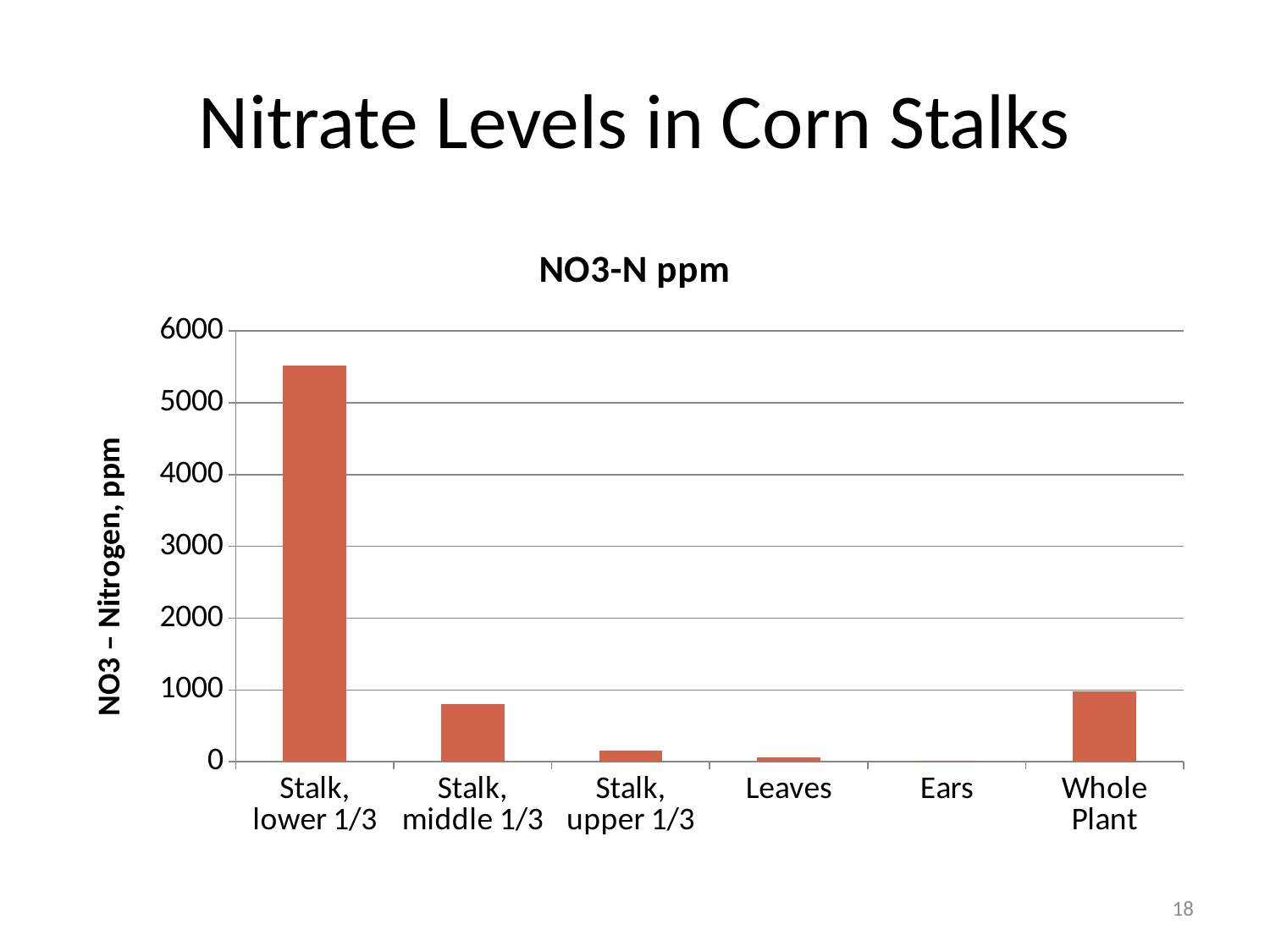
Is the value for Stalk, middle 1/3 greater or less than 1000? less Is the value for Stalk, upper 1/3 greater or less than 1000? less Is the value for Stalk, lower 1/3 greater or less than 5000? greater How many categories are shown on the x axis of the chart? 6 What kind of chart is shown on the slide? bar chart Which category has the highest NO3-N value? Stalk, lower 1/3 Which is larger, the value for Stalk, middle 1/3 or the value for Stalk, upper 1/3? Stalk, middle 1/3 Which category has the lowest NO3-N value? Ears What is the title of the chart? NO3-N ppm What is the label on the vertical axis of the chart? NO3 – Nitrogen, ppm Which is larger, the value for Whole Plant or the value for Leaves? Whole Plant